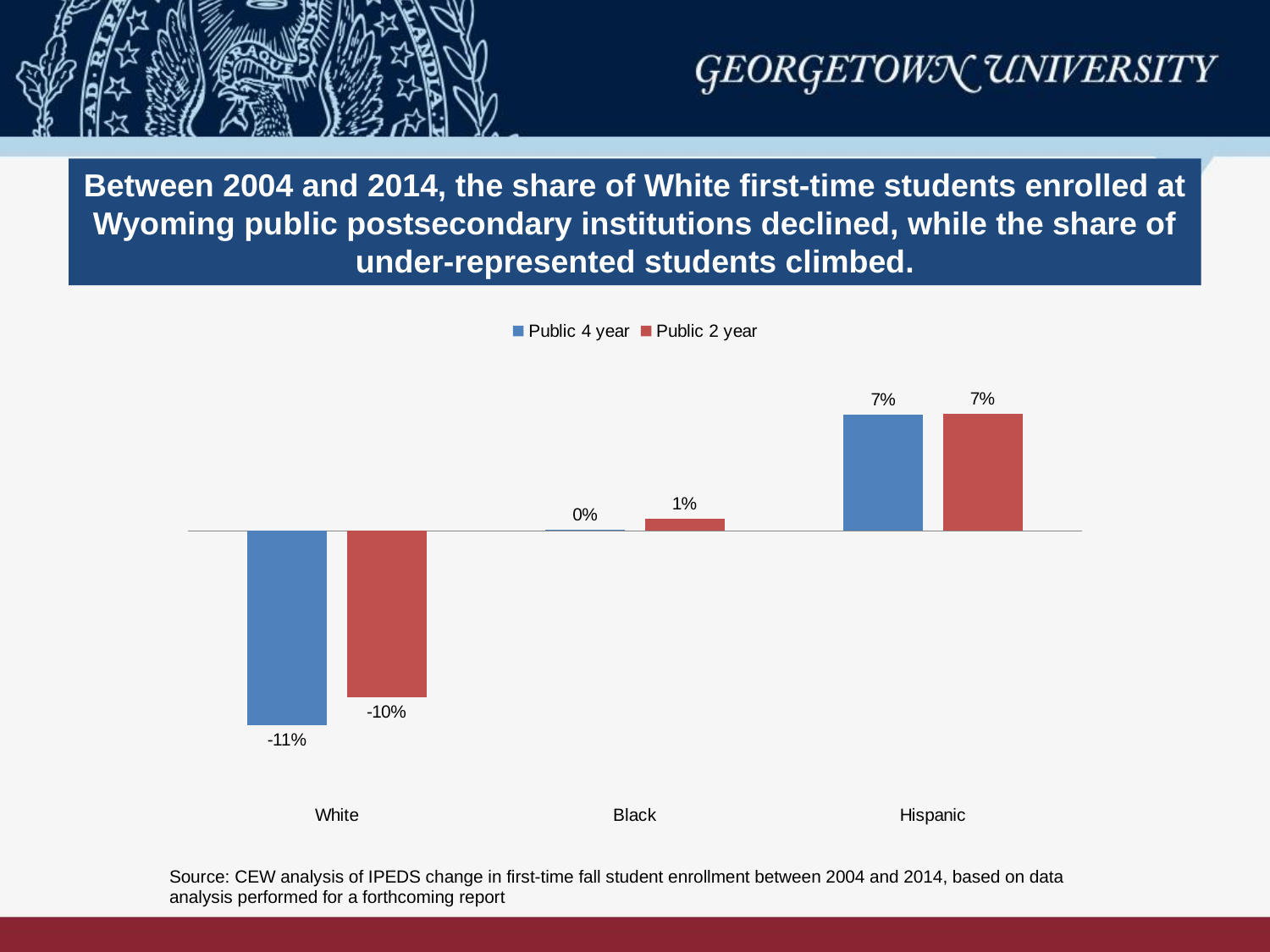
What is the value for Public 4 year in the White category? -11% Which category has the highest value for the Public 2 year series? Hispanic What is the value for Public 4 year in the Black category? 0% What kind of chart is shown on the slide? Bar chart What is the value for Public 4 year in the Hispanic category? 7% Which is larger in the White category, the Public 4 year value or the Public 2 year value? Public 2 year What is the difference between the Public 2 year values for Hispanic and Black? 6% What is the value for Public 2 year in the White category? -10% How many categories are shown on the x axis? 3 How many series does the legend list? 2 Which category has the lowest value for the Public 4 year series? White What is the value for Public 2 year in the Black category? 1%